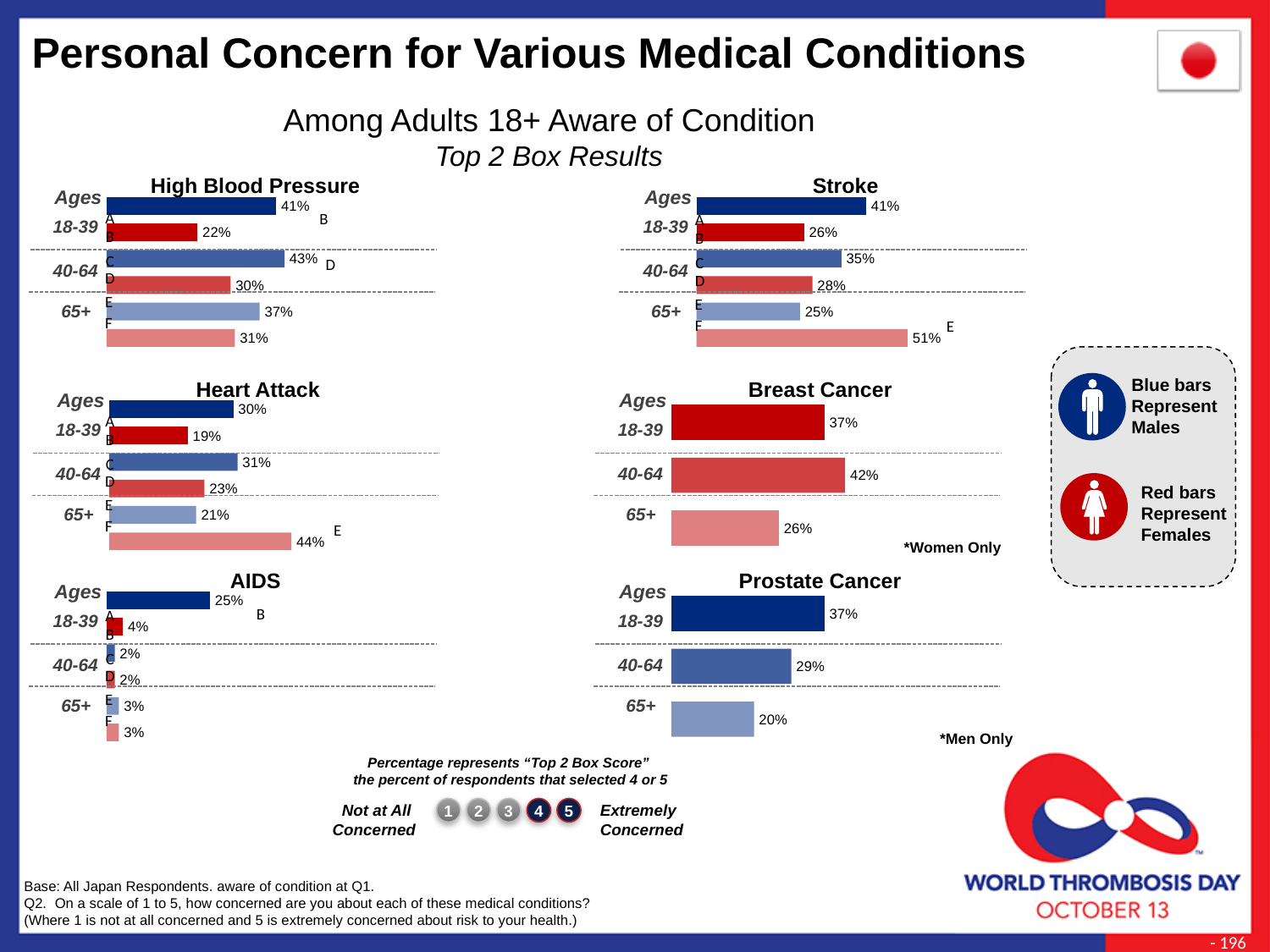
What type of chart is used for the Prostate Cancer data? Bar chart In the Prostate Cancer chart, which age group has the lowest value? 65+ In the Prostate Cancer chart, do the values rise or fall as age increases from 18-39 to 65+? Fall In the Stroke chart, what percentage of females aged 65+ are concerned? 51% In the High Blood Pressure chart, what percentage of males aged 40-64 are concerned? 43% In the Heart Attack chart, which is larger: the male 65+ value or the female 65+ value? Female 65+ (44%) According to the legend, what do the blue bars represent? Males In the AIDS chart, what is the value for males aged 18-39? 25% How many age groups are shown in the Breast Cancer chart? 3 In the Stroke chart, what is the difference between the female 65+ value and the male 65+ value? 26% In the Heart Attack chart, what is the value for females aged 18-39? 19% In the Breast Cancer chart, which age group has the highest value? 40-64